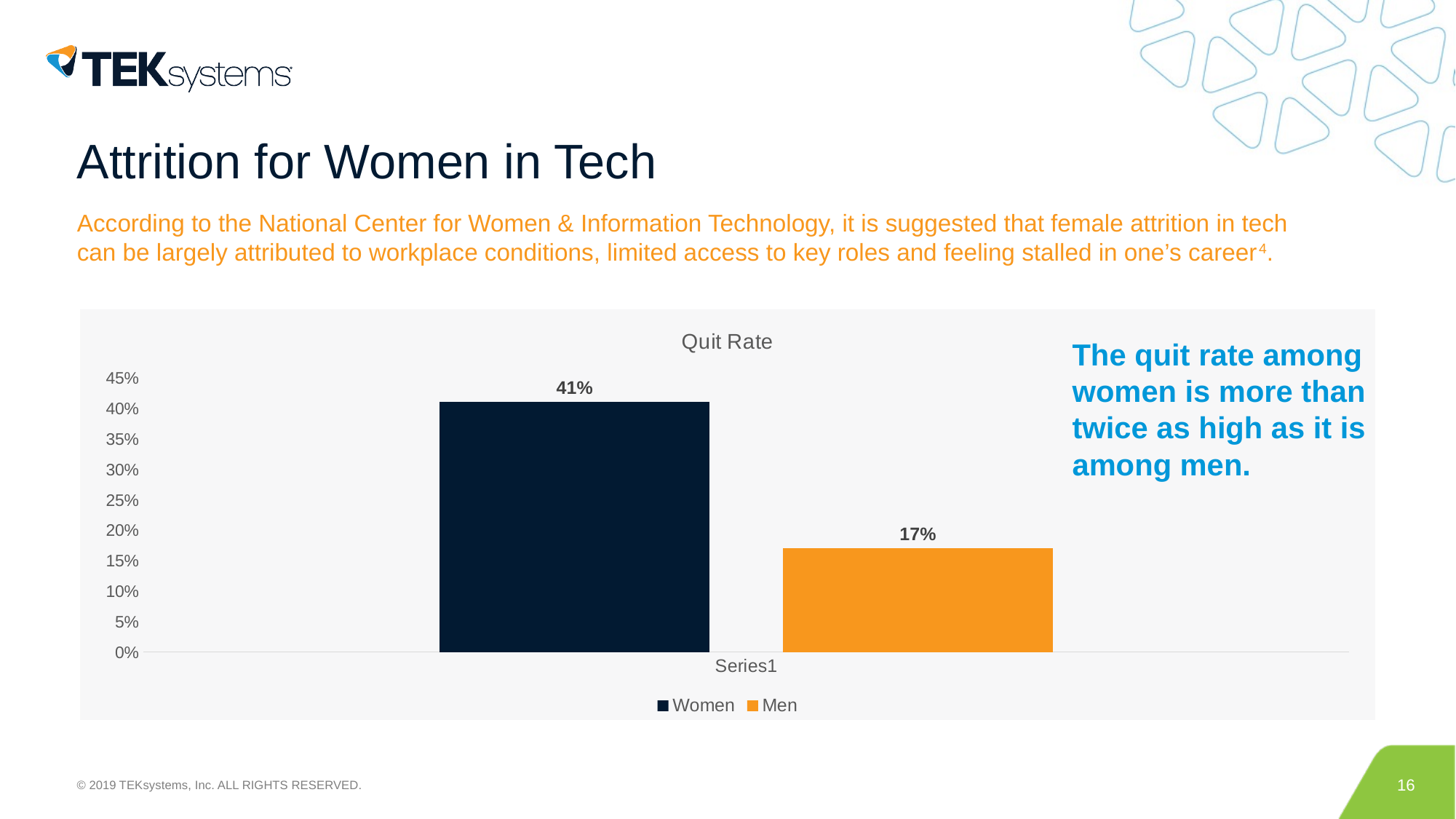
What is the highest value shown on the vertical axis? 45% Which series has the lower quit rate? Men Which series has the higher quit rate, Women or Men? Women What is the title of the chart? Quit Rate What colour is the bar for Men? Orange Is the quit rate for Women greater or less than 40%? greater What kind of chart is shown on the slide? Bar chart Is the quit rate for Men greater or less than 20%? less What is the difference between the quit rate for Women and the quit rate for Men? 24% How many series does the legend list? 2 What is the quit rate for Women? 41% What is the quit rate for Men? 17%